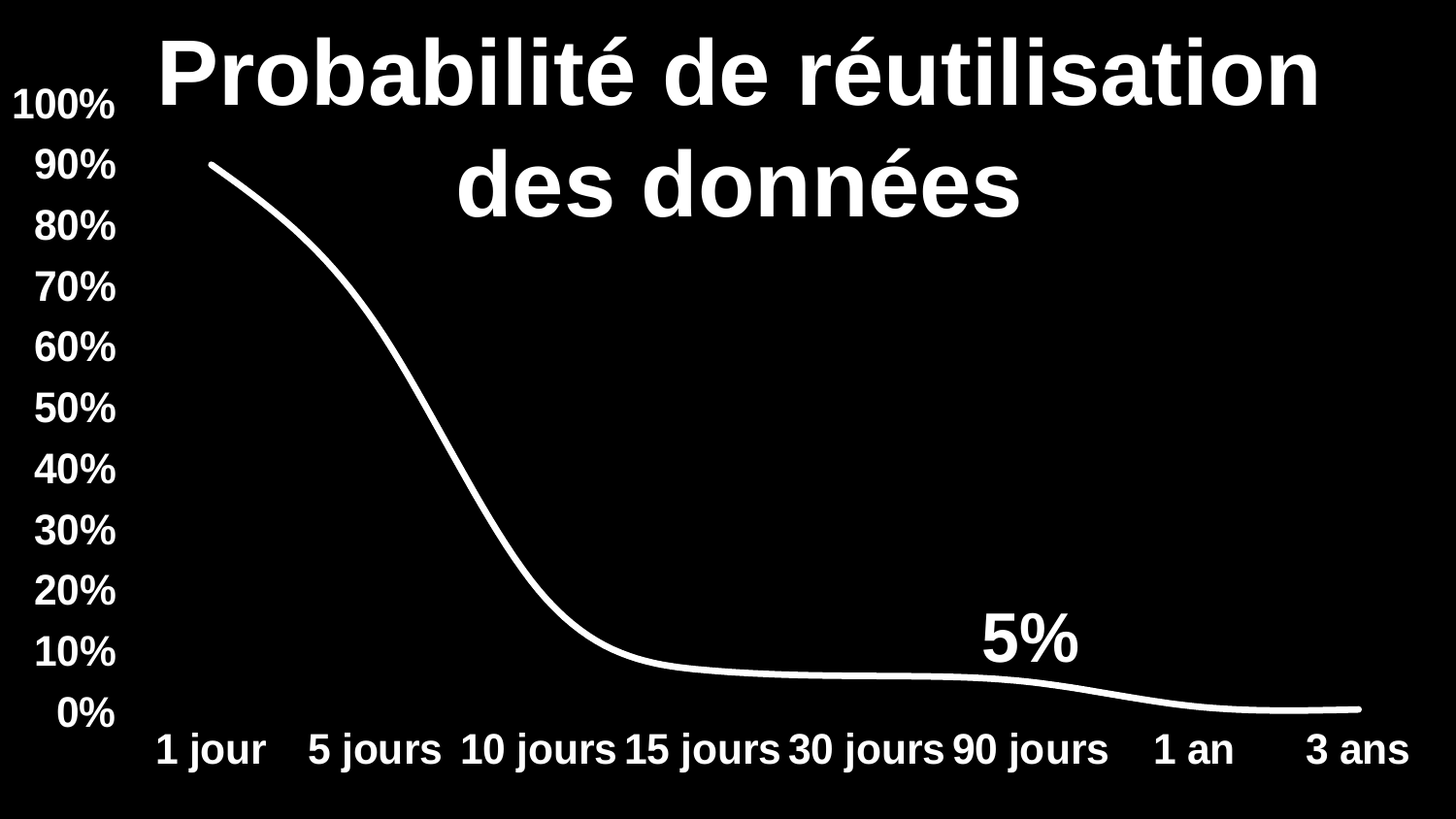
Is the value for 15 jours greater or less than 20%? less What is the probability of reuse at 90 jours? 5% What kind of chart is shown on the slide? line chart Which category has the highest probability of reuse? 1 jour What is the title of the chart? Probabilité de réutilisation des données What is the probability of reuse at 1 jour? 90% Do the values rise or fall along the x axis from 1 jour to 3 ans? fall How many time categories are shown on the x axis? 8 Which is larger, the value for 5 jours or the value for 10 jours? 5 jours Is the value for 5 jours greater or less than 60%? greater What is the difference between the probability at 1 jour and at 90 jours? 85% Is the value for 10 jours greater or less than 50%? less